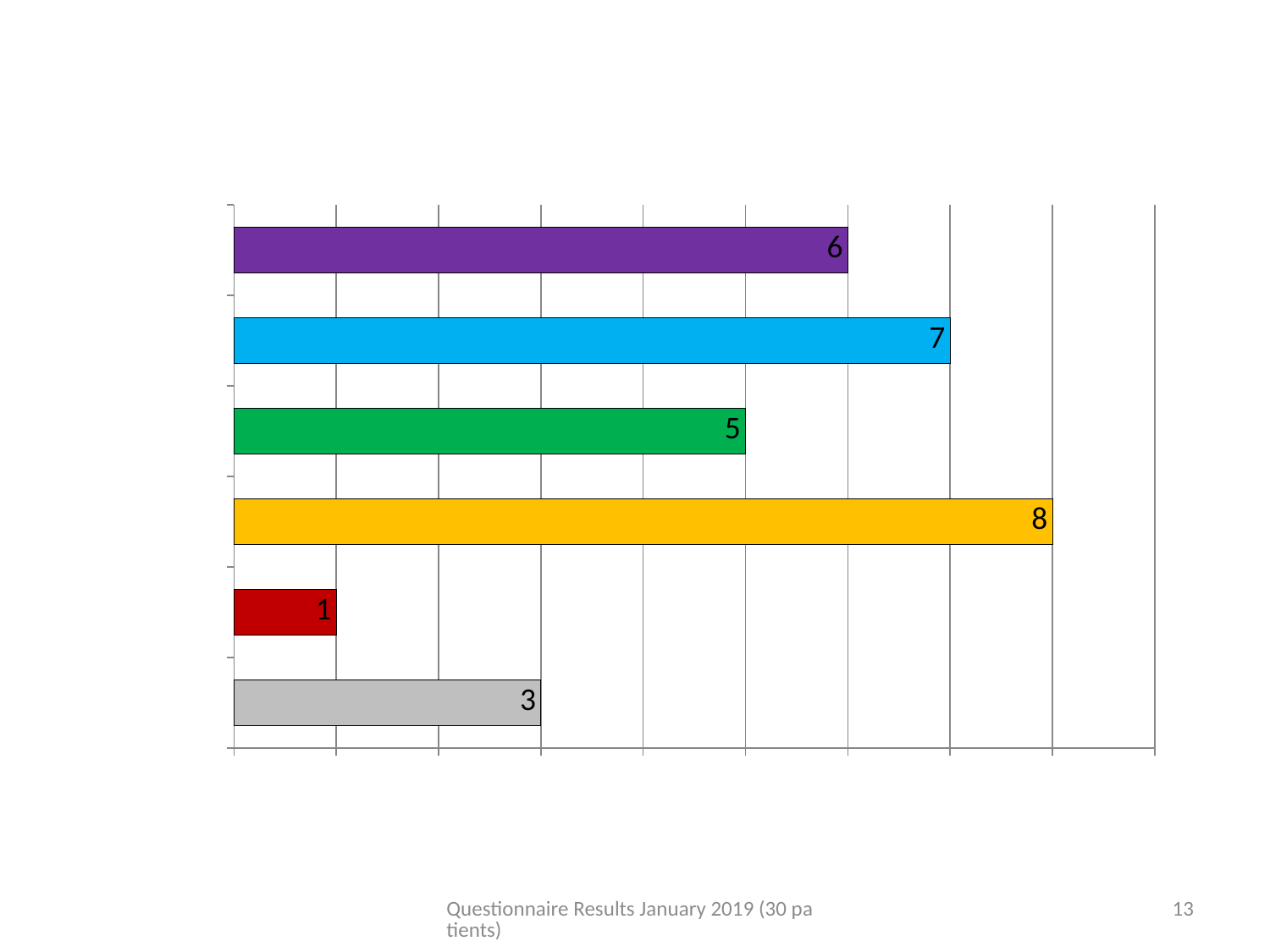
What is the value shown on the red bar? 1 What is the value shown on the green bar? 5 How many bars are plotted in the chart? 6 What is the difference between the highest and lowest bar values? 7 Which bar has the highest value? the yellow bar (8) What kind of chart is shown on the slide? bar chart What is the value shown on the bottom (grey) bar? 3 Which is larger, the value of the purple bar or the value of the grey bar? the purple bar What is the value shown on the yellow bar? 8 Which bar has the lowest value? the red bar (1) What is the difference between the values of the light blue bar and the green bar? 2 What is the value shown on the topmost (purple) bar? 6